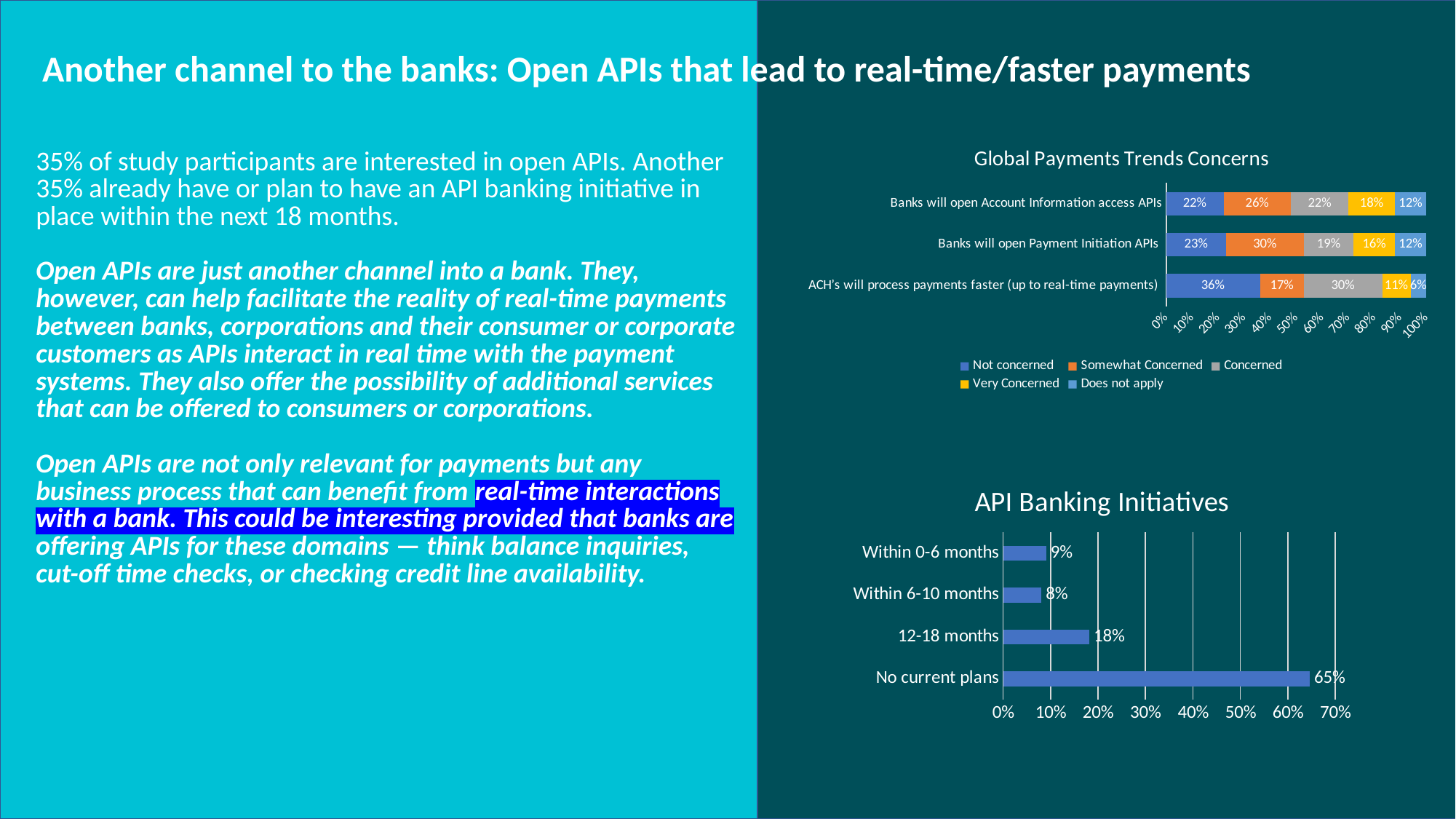
In the 'Global Payments Trends Concerns' chart, what is the 'Somewhat Concerned' value for 'Banks will open Payment Initiation APIs'? 30% In the 'Global Payments Trends Concerns' chart, which category has the highest 'Very Concerned' value? Banks will open Account Information access APIs In the 'Global Payments Trends Concerns' chart, what is the 'Not concerned' value for 'ACH's will process payments faster (up to real-time payments)'? 36% In the 'Global Payments Trends Concerns' chart, what colour represents 'Very Concerned' in the legend? Yellow In the 'API Banking Initiatives' chart, how many categories are shown? 4 In the 'API Banking Initiatives' chart, which category has the lowest value? Within 6-10 months In the 'API Banking Initiatives' chart, what is the difference between 'No current plans' and '12-18 months'? 47% In the 'Global Payments Trends Concerns' chart, how many series does the legend list? 5 In the 'API Banking Initiatives' chart, what is the value for 'No current plans'? 65% In the 'Global Payments Trends Concerns' chart, is the 'Concerned' value larger for 'ACH's will process payments faster (up to real-time payments)' or for 'Banks will open Payment Initiation APIs'? ACH's will process payments faster (up to real-time payments) In the 'API Banking Initiatives' chart, what is the value for '12-18 months'? 18% What kind of chart is 'API Banking Initiatives'? Bar chart